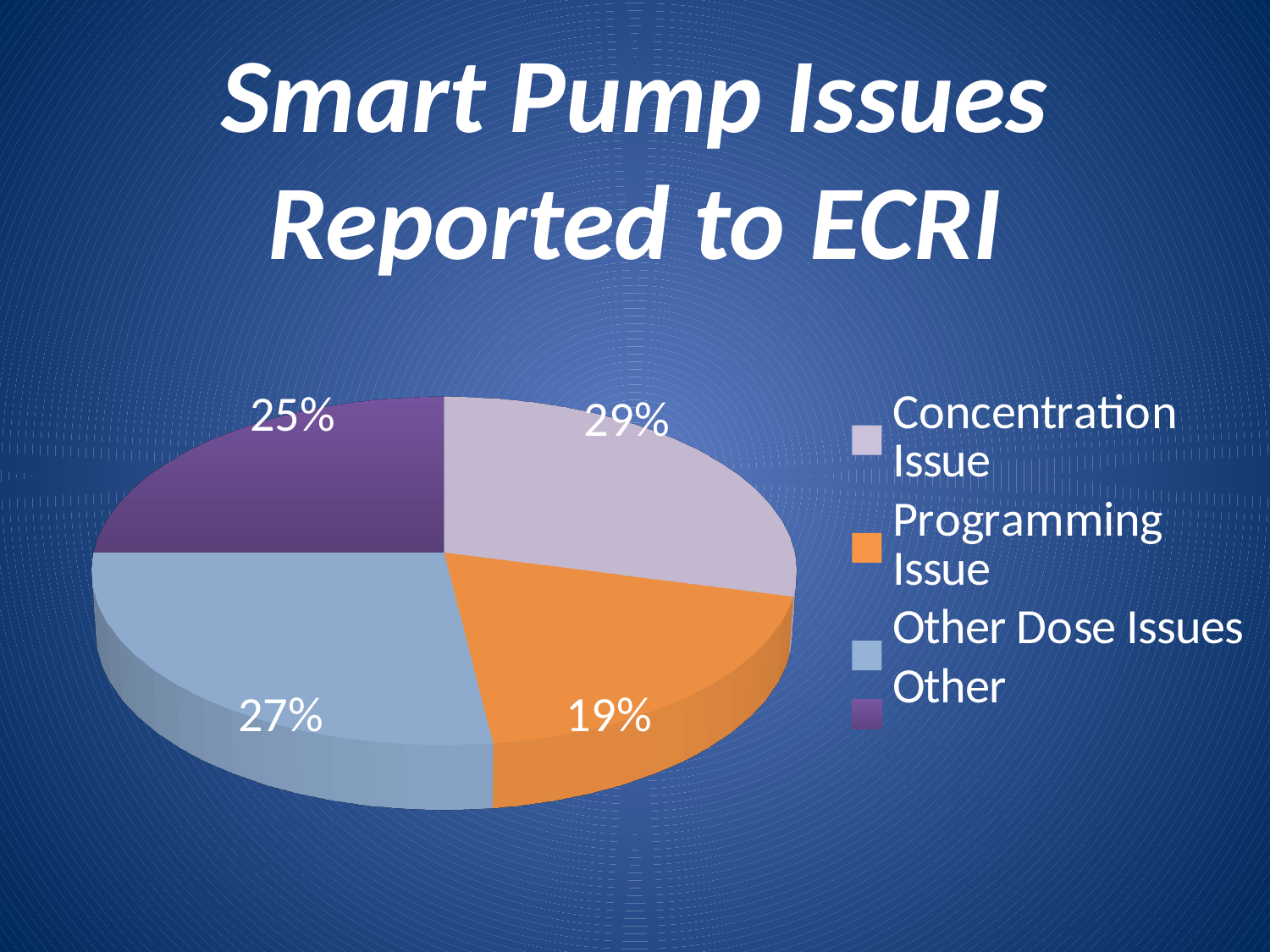
What is the difference in percentage points between Concentration Issue and Programming Issue? 10 Which category has the smallest share of the pie? Programming Issue What share of the pie does Other represent? 25% Which category is shown in orange in the legend? Programming Issue What share of the pie does Other Dose Issues represent? 27% How many categories are shown in the pie chart? 4 Which is larger, the share for Other Dose Issues or the share for Other? Other Dose Issues What share of the pie does Concentration Issue represent? 29% What is the title of the chart? Smart Pump Issues Reported to ECRI What share of the pie does Programming Issue represent? 19% Which category has the largest share of the pie? Concentration Issue What kind of chart is shown on the slide? Pie chart